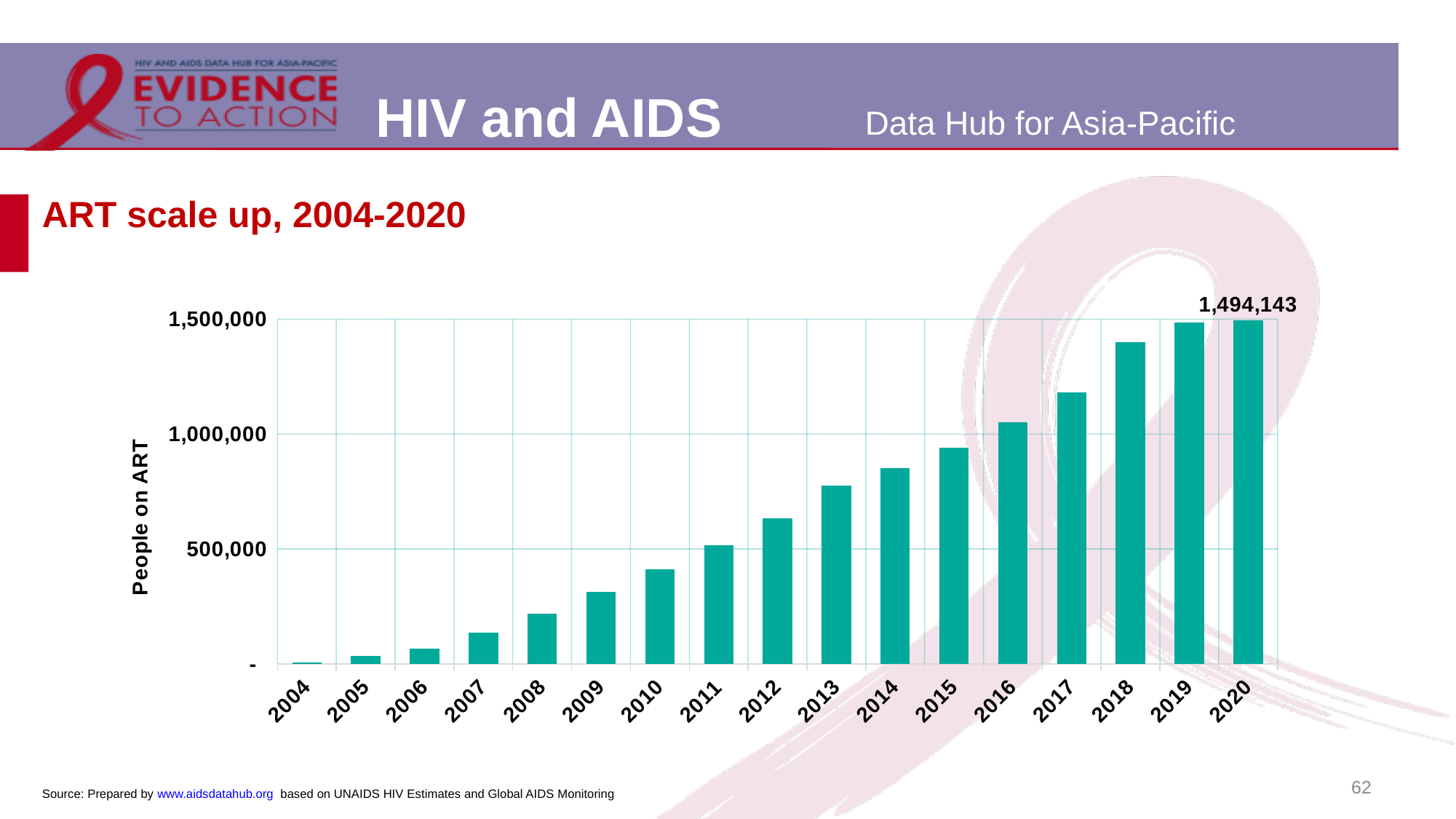
Which year has the lowest number of people on ART? 2004 Is the value for 2012 greater or less than 500,000? greater Is the value for 2015 greater or less than 1,000,000? less Is the value for 2018 greater or less than 1,500,000? less Do the values rise or fall from 2004 to 2020? Rise Which year has the highest number of people on ART? 2020 Which year has more people on ART, 2013 or 2019? 2019 What kind of chart is shown on the slide? Bar chart What is the value for 2020 in the ART scale up chart? 1,494,143 How many years are shown on the x axis of the chart? 17